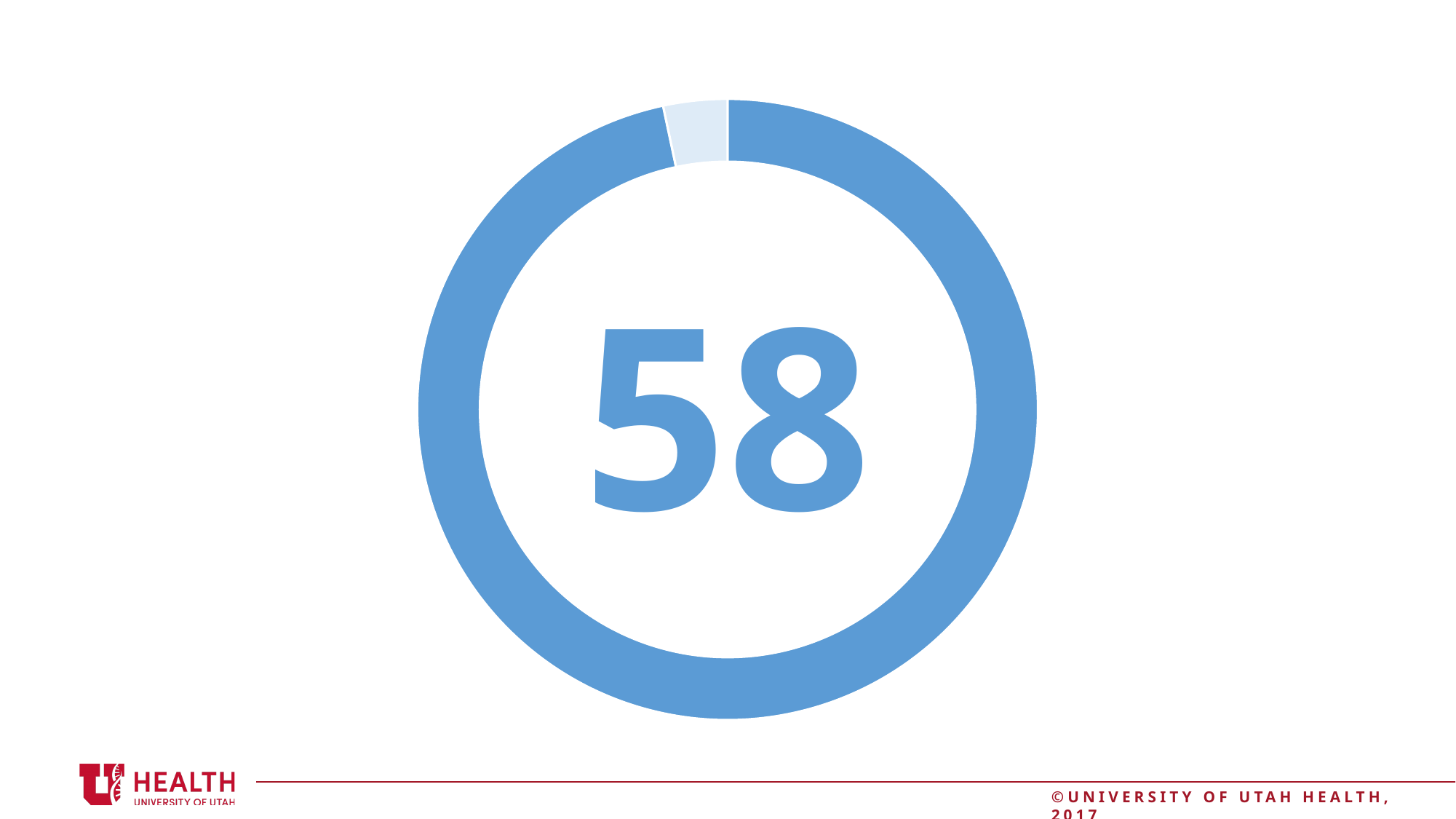
What number is displayed in the centre of the doughnut chart? 58 How many segments does the doughnut chart have? 2 Which segment of the doughnut chart is larger, the dark blue one or the light blue one? The dark blue one What kind of chart is shown on the slide? Doughnut chart What colour is the larger segment of the doughnut chart? Blue